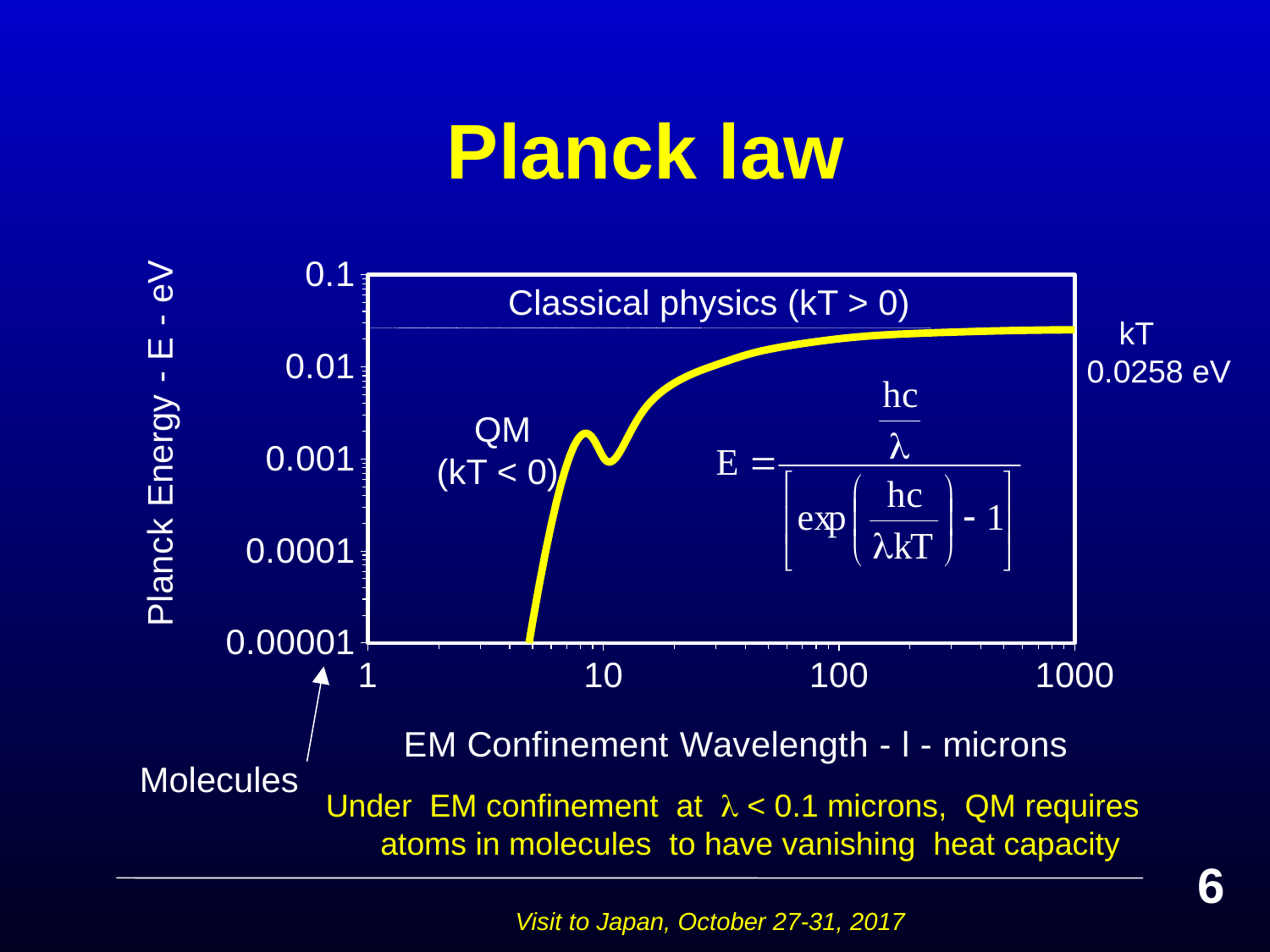
What kind of chart is shown on the slide? line chart What is the label of the y axis of the chart? Planck Energy - E - eV What value of kT is annotated at the right of the chart? 0.0258 eV Is the value of the curve at 1000 microns greater or less than 0.1? less How many labeled tick values are shown on the x axis? 4 Is the value of the curve at 100 microns greater or less than 0.001? greater Does the plotted curve rise or fall as the wavelength increases from 10 to 1000 microns? rise Is the value of the curve at 1000 microns greater or less than 0.01? greater How many curves are plotted on the chart? 1 What is the title of the chart on the slide? Planck law How many labeled tick values are shown on the y axis? 5